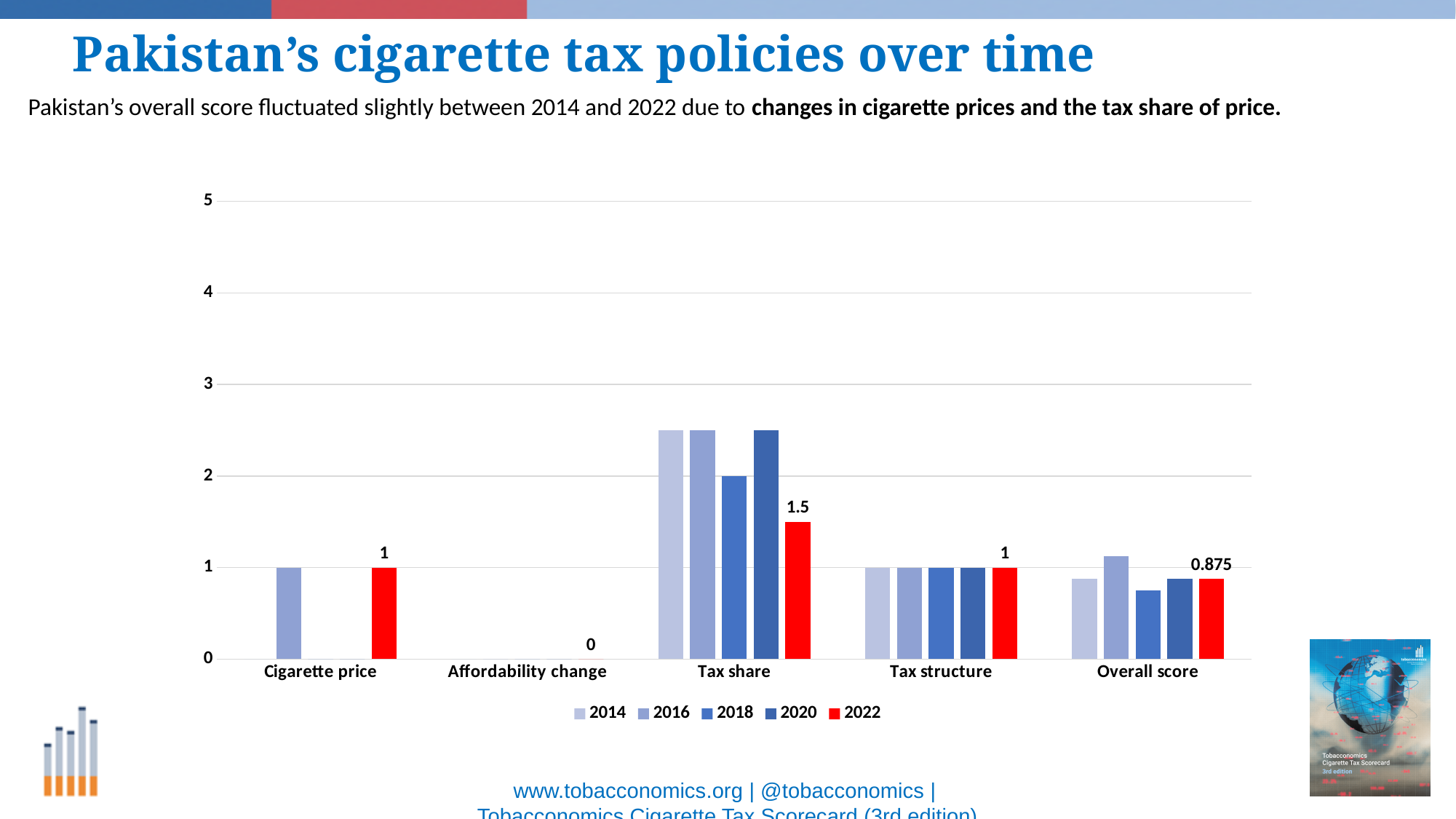
How many series does the legend list? 5 What kind of chart is shown on the slide? bar chart What is the difference between the 2022 values for Tax share and Tax structure? 0.5 Which is larger for Tax share: the 2018 value or the 2022 value? 2018 How many categories are shown on the x axis? 5 Is the value for Tax share in 2014 greater or less than 2? greater What is the value for Overall score in 2022? 0.875 What is the value for Tax share in 2022? 1.5 Among the 2022 bars, which category has the highest value? Tax share What is the value for Affordability change in 2022? 0 Which colour represents the 2022 series in the legend? red What is the value for Cigarette price in 2022? 1